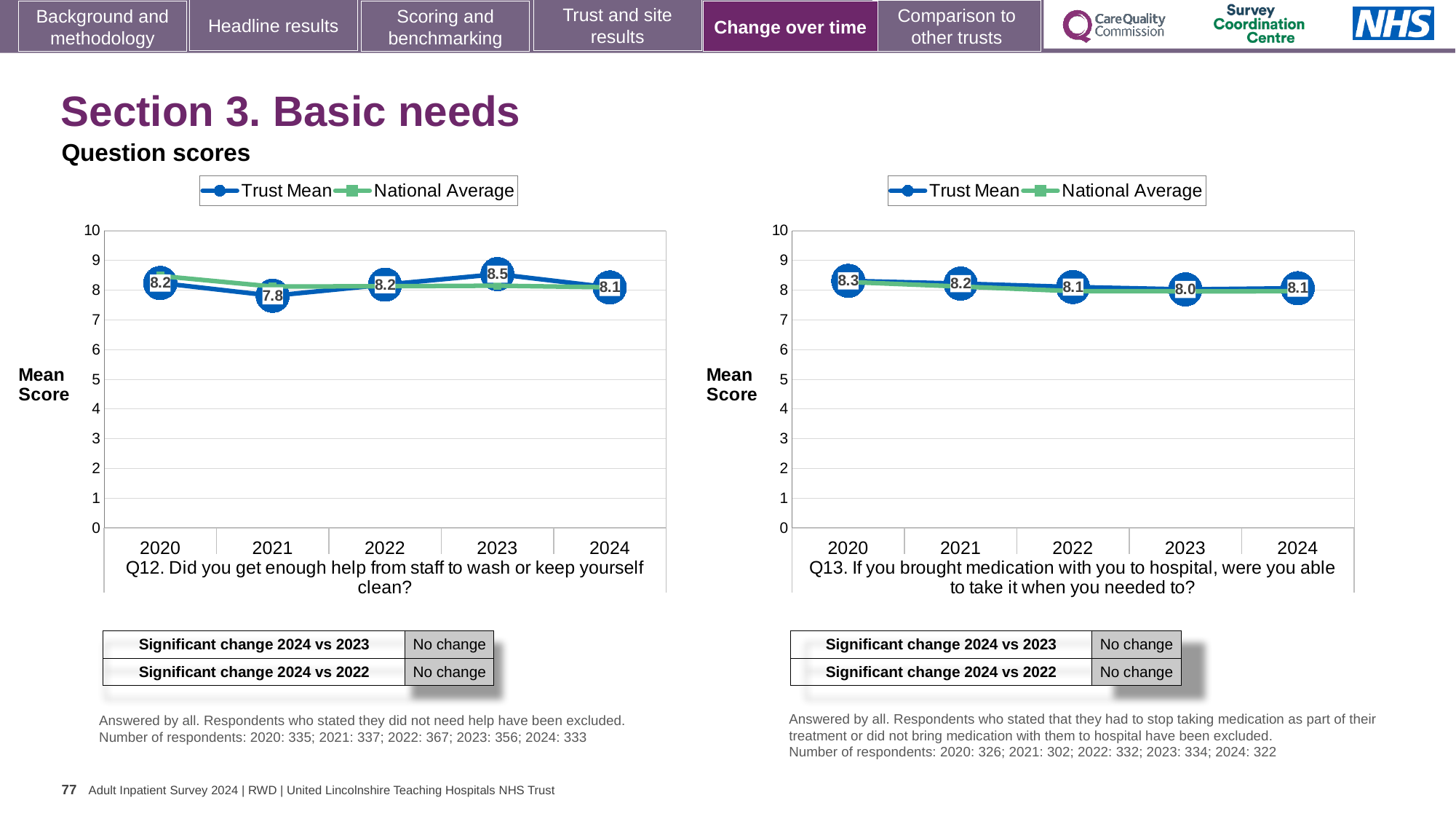
On the Q13 chart (right), is the Trust Mean for 2020 larger or smaller than the Trust Mean for 2023? larger On the Q13 chart (right), what is the Trust Mean for 2023? 8.0 On the Q12 chart (left), what is the difference between the Trust Mean in 2023 and in 2021? 0.7 How many series does the legend of the Q12 chart (left) list? 2 On the Q12 chart (left), which year has the lowest Trust Mean? 2021 How many years are plotted on the Q13 chart (right)? 5 On the Q12 chart (left), what is the Trust Mean for 2023? 8.5 On the Q13 chart (right), what is the Trust Mean for 2020? 8.3 On the Q12 chart (left), which year has the highest Trust Mean? 2023 What type of chart is the Q12 chart (left)? Line chart On the Q13 chart (right), which year has the highest Trust Mean? 2020 On the Q12 chart (left), what is the Trust Mean for 2021? 7.8